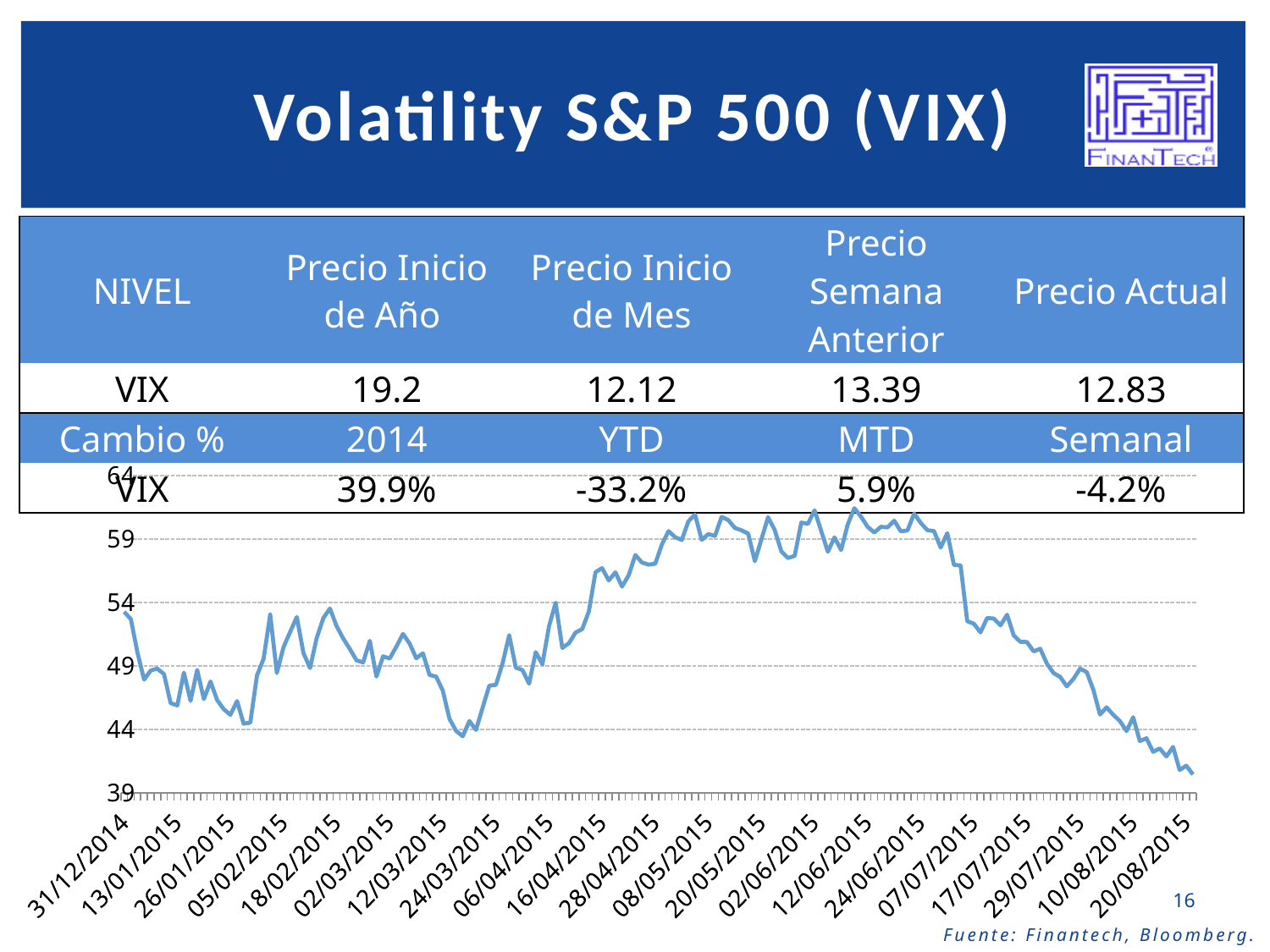
Does the line rise or fall between 07/07/2015 and 20/08/2015? fall What kind of chart is shown on the slide? line chart How many date labels are shown on the x axis of the chart? 21 Is the value at 31/12/2014 greater or less than 49? greater What is the last date label on the x axis of the chart? 20/08/2015 Is the value at 20/08/2015 greater or less than 44? less Does the line rise or fall between 24/03/2015 and 08/05/2015? rise What is the first date label on the x axis of the chart? 31/12/2014 Is the value at 08/05/2015 greater or less than 54? greater Which is larger, the value at 31/12/2014 or the value at 20/08/2015? 31/12/2014 How many series are plotted in the chart? 1